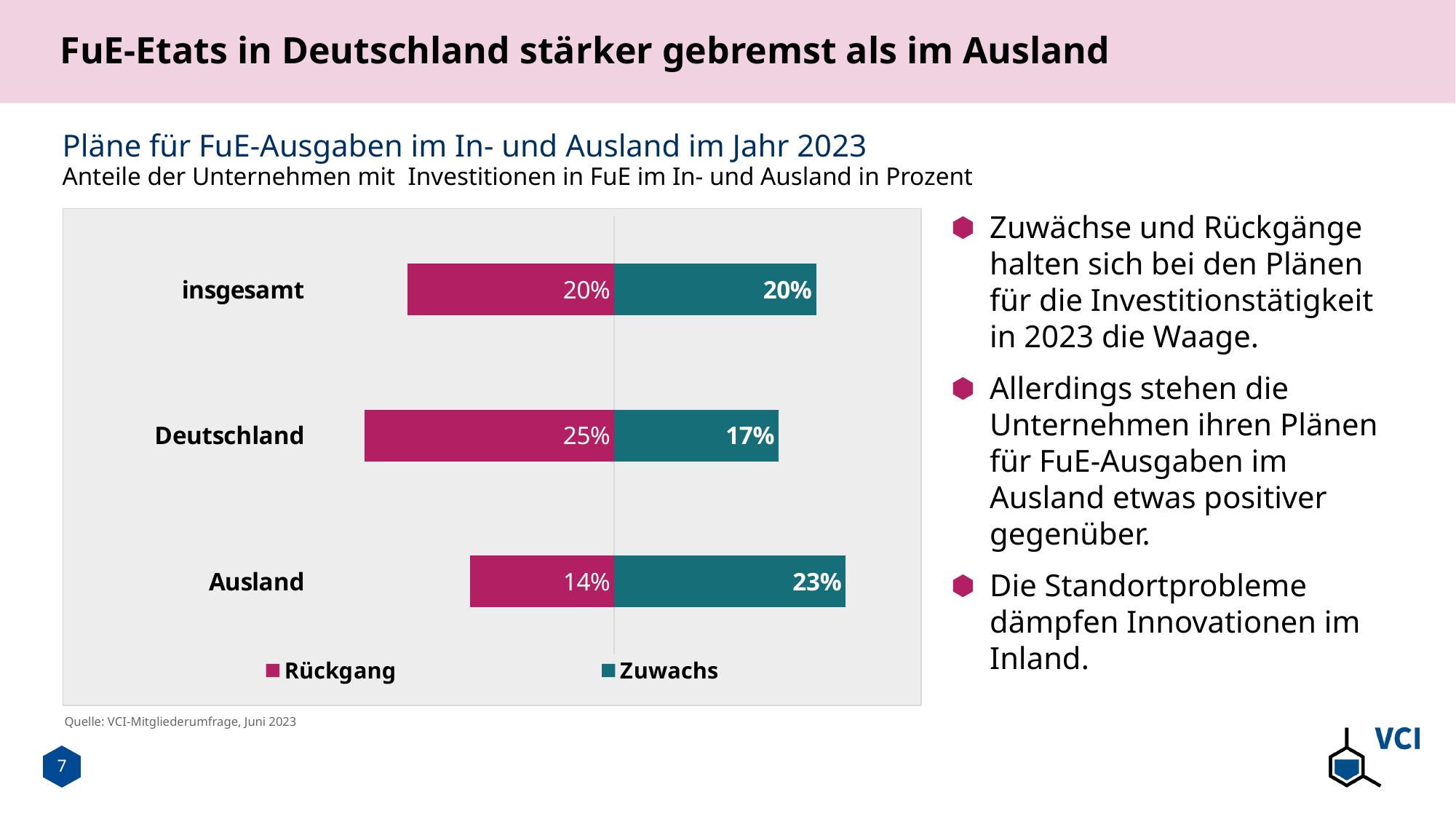
How many series does the legend list? 2 What is the Zuwachs value for Ausland? 23% What is the Rückgang value for Ausland? 14% Which is larger for Ausland, the Rückgang value or the Zuwachs value? Zuwachs Which category has the lowest Zuwachs value? Deutschland What is the Zuwachs value for insgesamt? 20% What is the difference between the Rückgang and Zuwachs values for Deutschland? 8% What is the title of the chart? Pläne für FuE-Ausgaben im In- und Ausland im Jahr 2023 Which category has the highest Rückgang value? Deutschland What kind of chart is shown on the slide? Bar chart What is the Rückgang value for Deutschland? 25% How many categories are shown in the chart? 3